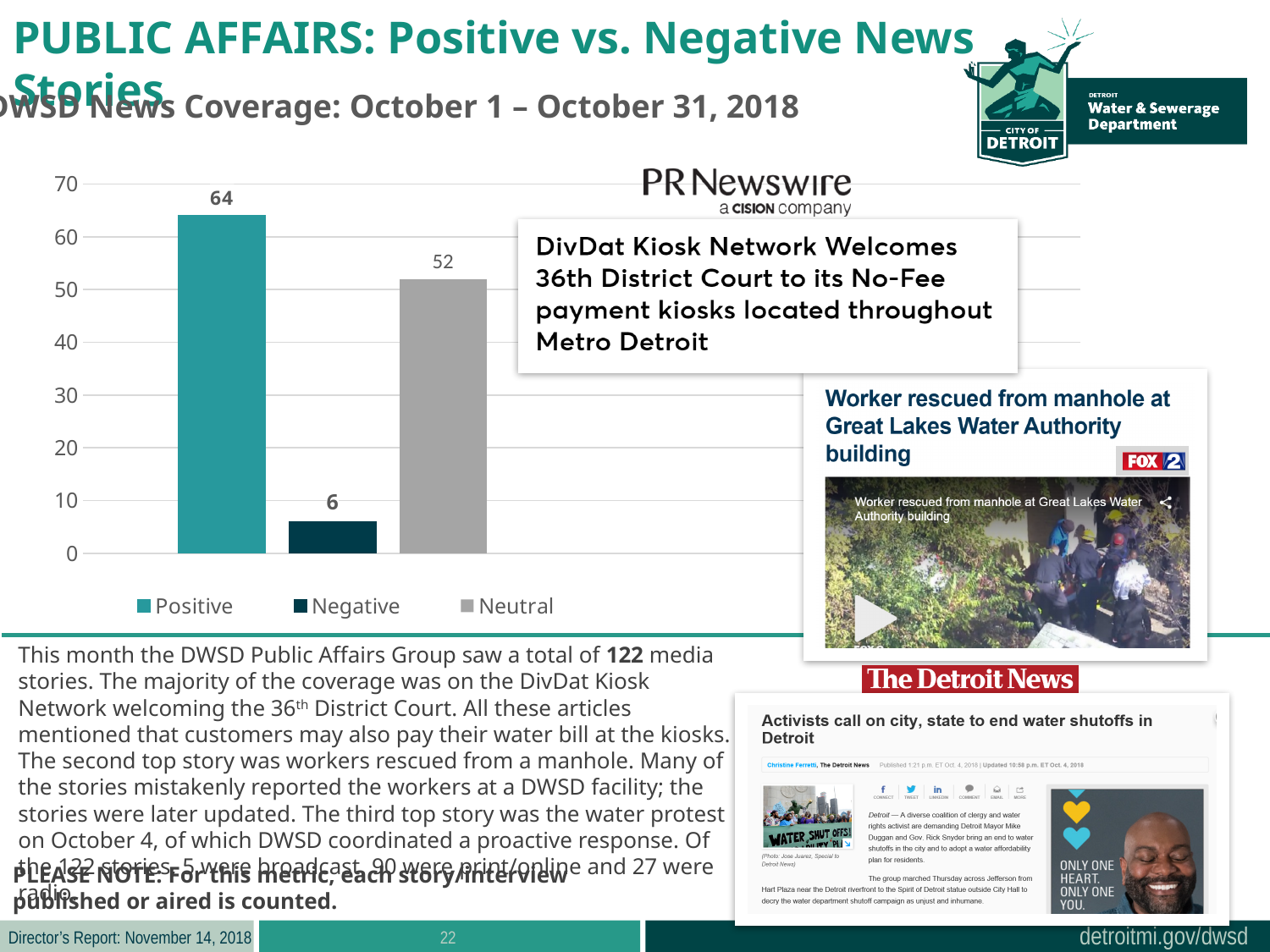
Is the value for Neutral greater or less than 50? greater Which category has the lowest number of news stories? Negative What is the value for Positive news stories? 64 What is the difference between the Positive and Neutral values? 12 Which is larger, the Neutral value or the Negative value? Neutral What is the difference between the Positive and Negative values? 58 How many series does the legend list? 3 What kind of chart is shown on the slide? Bar chart Which category has the highest number of news stories? Positive What is the value for Neutral news stories? 52 What is the total of the Positive, Negative and Neutral values? 122 What is the value for Negative news stories? 6